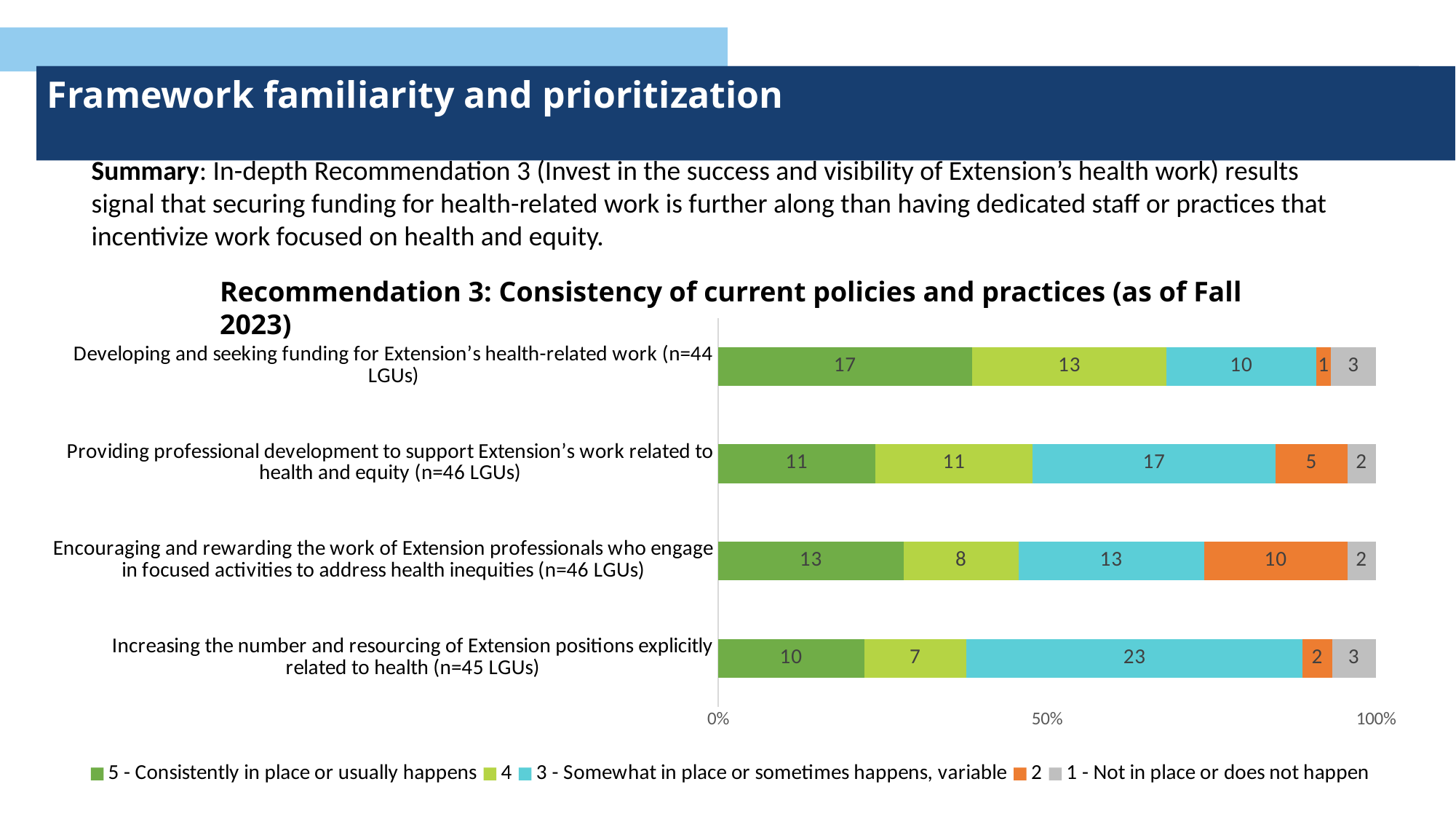
Which practice has the lowest number of LGUs rating it '5 - Consistently in place or usually happens'? Increasing the number and resourcing of Extension positions explicitly related to health What is the difference between the number of LGUs rating 'Increasing the number and resourcing of Extension positions explicitly related to health' as '3' and the number rating 'Developing and seeking funding for Extension's health-related work' as '3'? 13 What is the total number of LGUs across all rating levels for 'Developing and seeking funding for Extension's health-related work'? 44 Which practice has the highest number of LGUs rating it '5 - Consistently in place or usually happens'? Developing and seeking funding for Extension's health-related work How many LGUs rated 'Increasing the number and resourcing of Extension positions explicitly related to health' as '3 - Somewhat in place or sometimes happens, variable'? 23 How many LGUs gave a rating of '2' for 'Encouraging and rewarding the work of Extension professionals who engage in focused activities to address health inequities'? 10 What does the grey segment in the chart represent according to the legend? 1 - Not in place or does not happen How many rating levels (series) does the chart legend list? 5 In the chart 'Recommendation 3: Consistency of current policies and practices', how many LGUs rated 'Developing and seeking funding for Extension's health-related work' as '5 - Consistently in place or usually happens'? 17 How many practices (categories) are shown in the chart? 4 What type of chart is shown on the slide? Stacked bar chart Which has more LGUs with a rating of '4': 'Developing and seeking funding for Extension's health-related work' or 'Providing professional development to support Extension's work related to health and equity'? Developing and seeking funding for Extension's health-related work